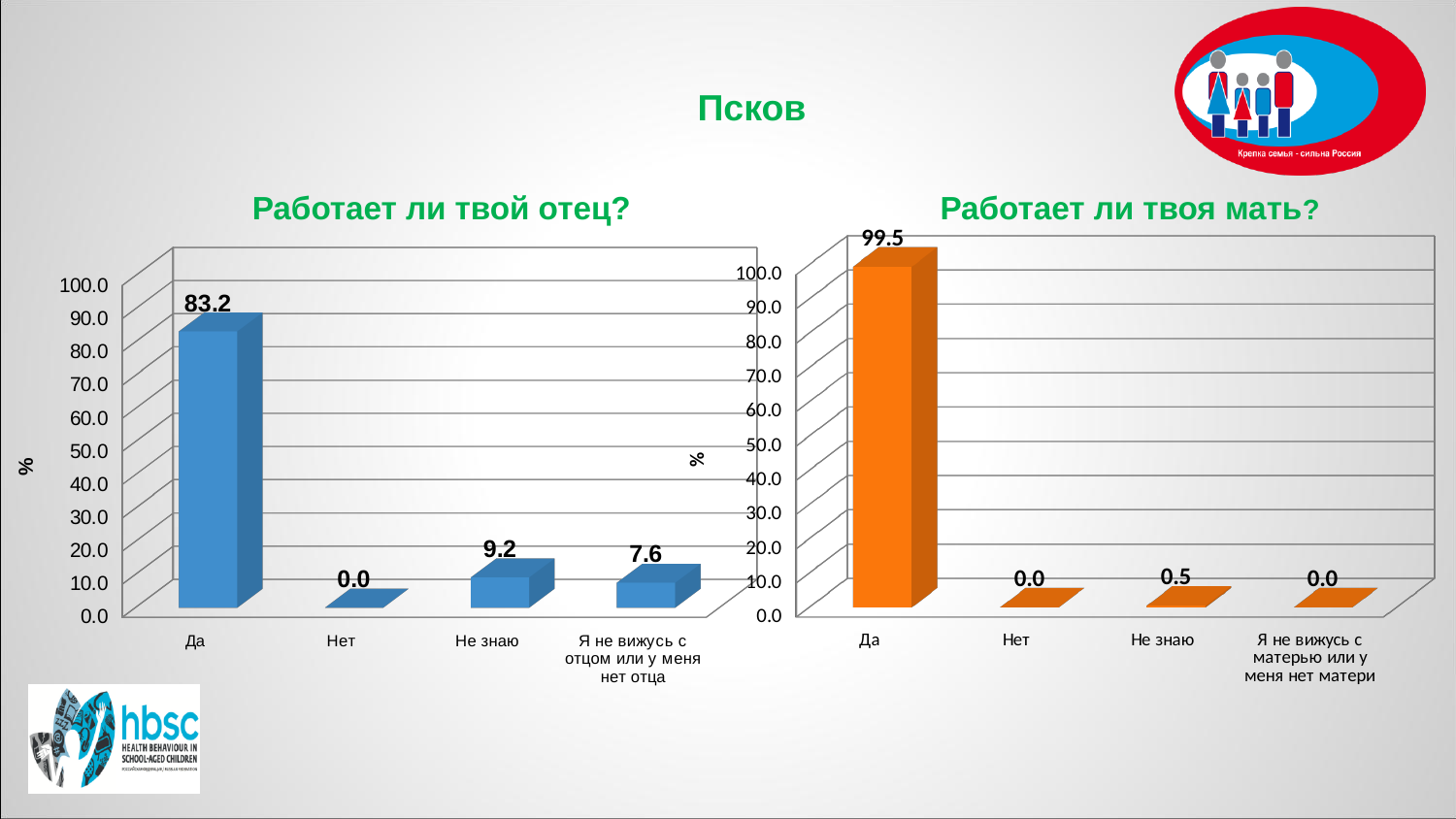
In the chart "Работает ли твой отец?", what is the value for "Да"? 83.2 In the chart "Работает ли твой отец?", which category has the highest value? Да How many categories are shown in the chart "Работает ли твоя мать?"? 4 In the chart "Работает ли твой отец?", what is the value for "Не знаю"? 9.2 What type of chart is "Работает ли твой отец?"? Bar chart In the chart "Работает ли твой отец?", what is the value for "Я не вижусь с отцом или у меня нет отца"? 7.6 Which is larger: the value for "Да" in the chart "Работает ли твой отец?" or the value for "Да" in the chart "Работает ли твоя мать?"? Работает ли твоя мать? What colour are the bars in the chart "Работает ли твоя мать?"? Orange In the chart "Работает ли твоя мать?", what is the value for "Не знаю"? 0.5 In the chart "Работает ли твоя мать?", what is the value for "Да"? 99.5 In the chart "Работает ли твой отец?", what is the difference between the values for "Не знаю" and "Я не вижусь с отцом или у меня нет отца"? 1.6 In the chart "Работает ли твоя мать?", which category has the highest value? Да